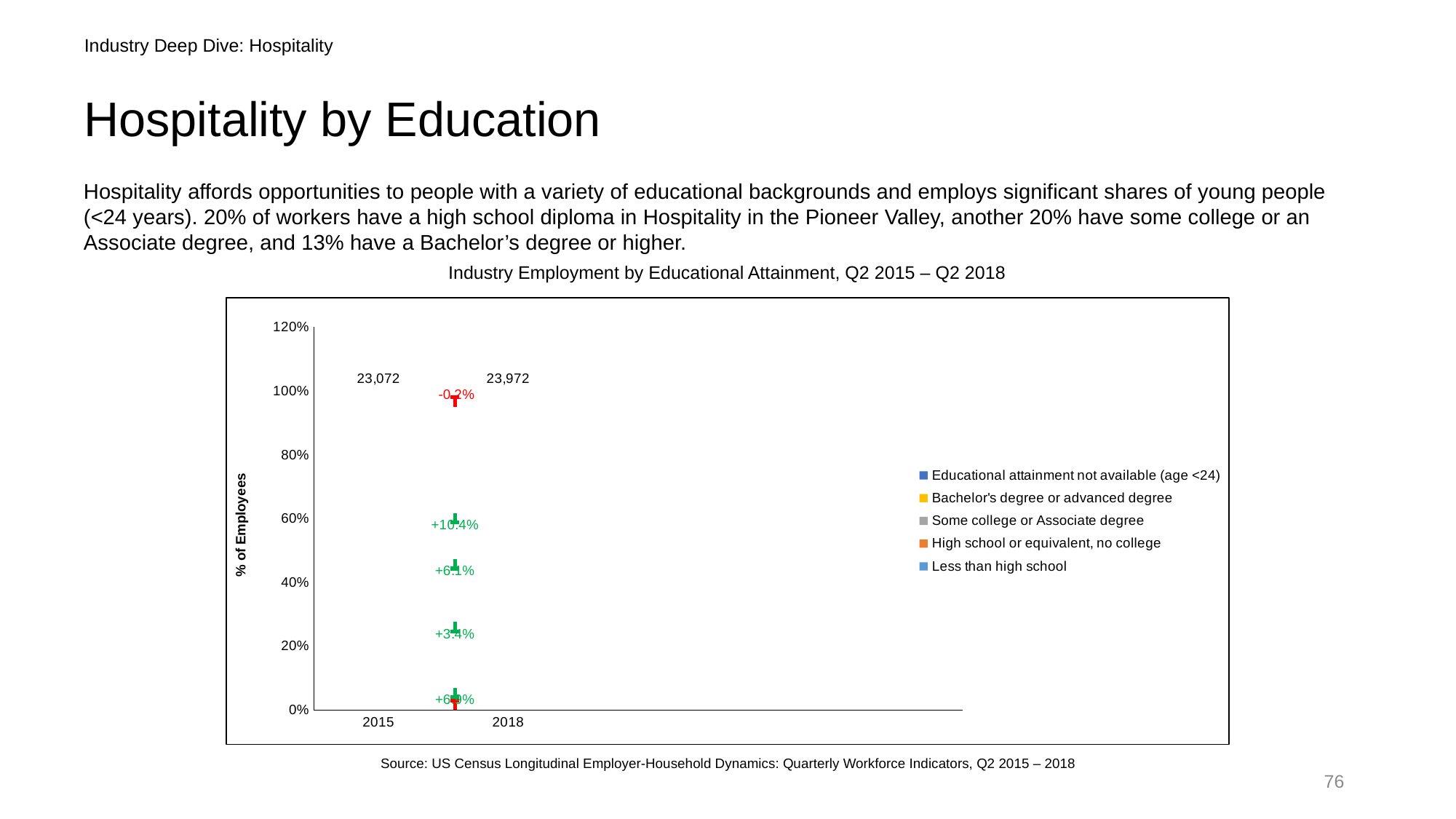
Which year has the higher total employment figure, 2015 or 2018? 2018 What total employment figure is printed above the 2018 column? 23,972 What total employment figure is printed above the 2015 column? 23,072 What is the difference between the 2018 and 2015 total employment figures? 900 What is the largest positive change value printed between the two columns? +10.4% What is the change value printed in red near the top of the chart? -0.2% How many years are shown on the x axis of the chart? 2 What is the highest value shown on the y axis? 120% How many series does the chart legend list? 5 What is the label on the y axis of the chart? % of Employees What is the title of the chart? Industry Employment by Educational Attainment, Q2 2015 – Q2 2018